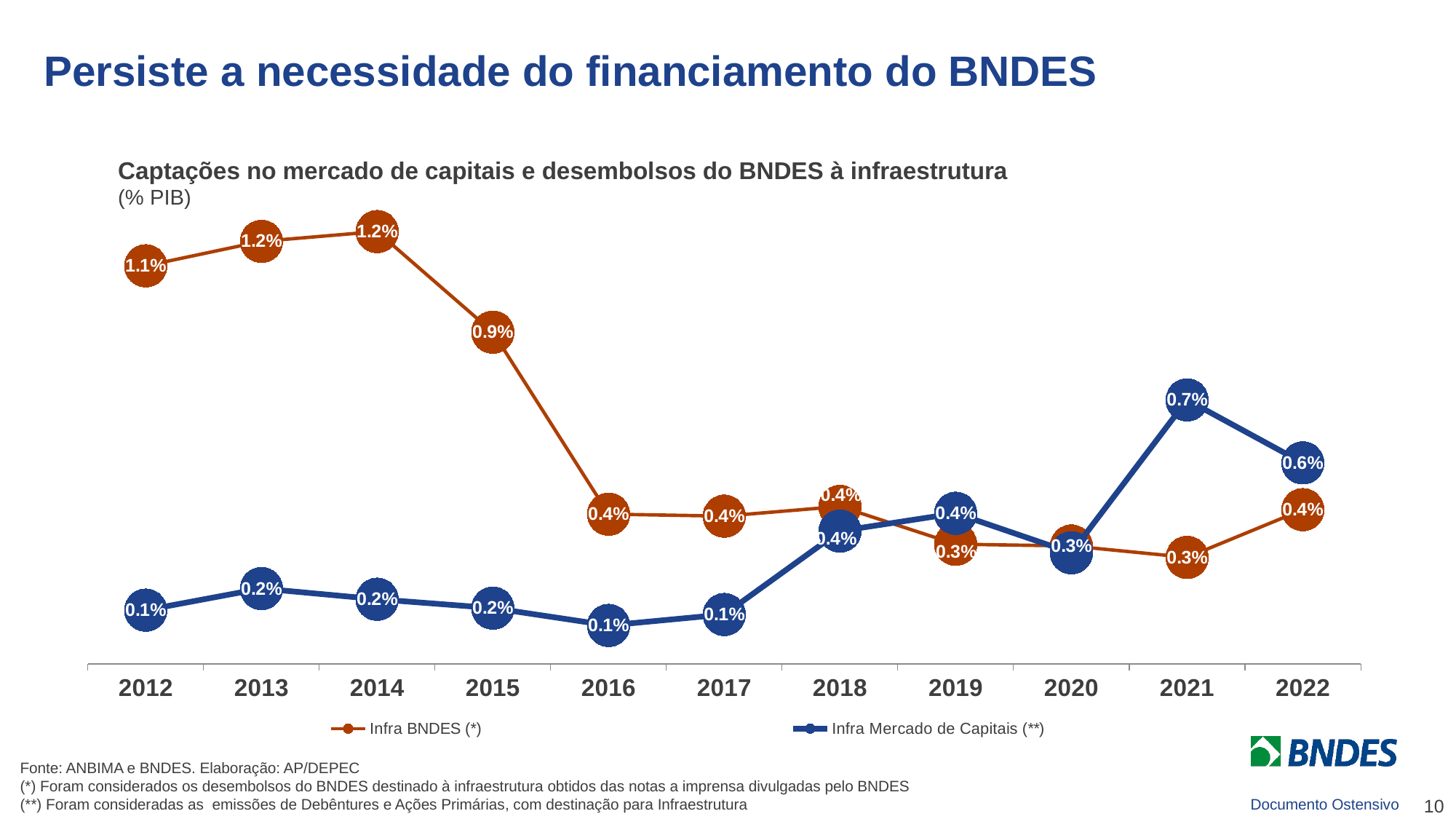
What kind of chart is shown on the slide? Line chart By how much did Infra BNDES (*) fall from 2015 to 2016? 0.5 percentage points Does the Infra BNDES (*) series rise or fall from 2014 to 2016? Fall What is the value for Infra Mercado de Capitais (**) in 2022? 0.6% What is the value for Infra Mercado de Capitais (**) in 2021? 0.7% In which year does Infra Mercado de Capitais (**) reach its highest value? 2021 What is the value for Infra BNDES (*) in 2015? 0.9% How many series does the legend list? 2 How many years are shown on the x axis? 11 What is the value for Infra BNDES (*) in 2012? 1.1% In 2022, which series has the higher value, Infra BNDES (*) or Infra Mercado de Capitais (**)? Infra Mercado de Capitais (**) What is the difference between Infra BNDES (*) and Infra Mercado de Capitais (**) in 2012? 1.0 percentage points